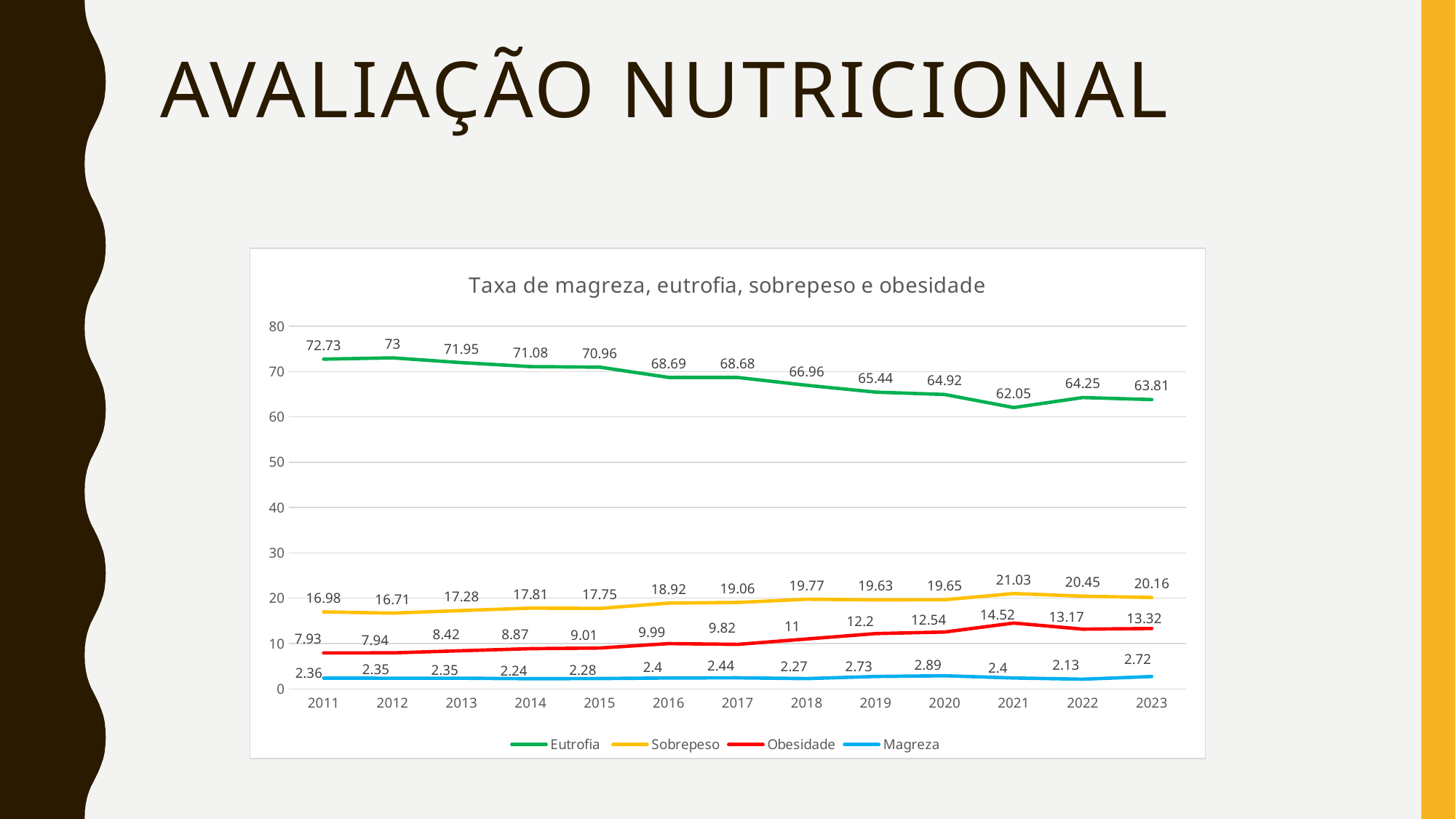
What is the value for Magreza in 2020? 2.89 How many years are shown on the x axis? 13 What is the value for Eutrofia in 2011? 72.73 Which year has the larger Obesidade value, 2019 or 2020? 2020 In which year is the Eutrofia value lowest? 2021 What kind of chart is shown on the slide? Line chart What is the value for Obesidade in 2021? 14.52 How many series does the legend list? 4 What is the difference between the Eutrofia value in 2011 and in 2023? 8.92 What is the title of the chart? Taxa de magreza, eutrofia, sobrepeso e obesidade In which year is the Sobrepeso value highest? 2021 Does the Eutrofia series generally rise or fall from 2011 to 2023? Fall